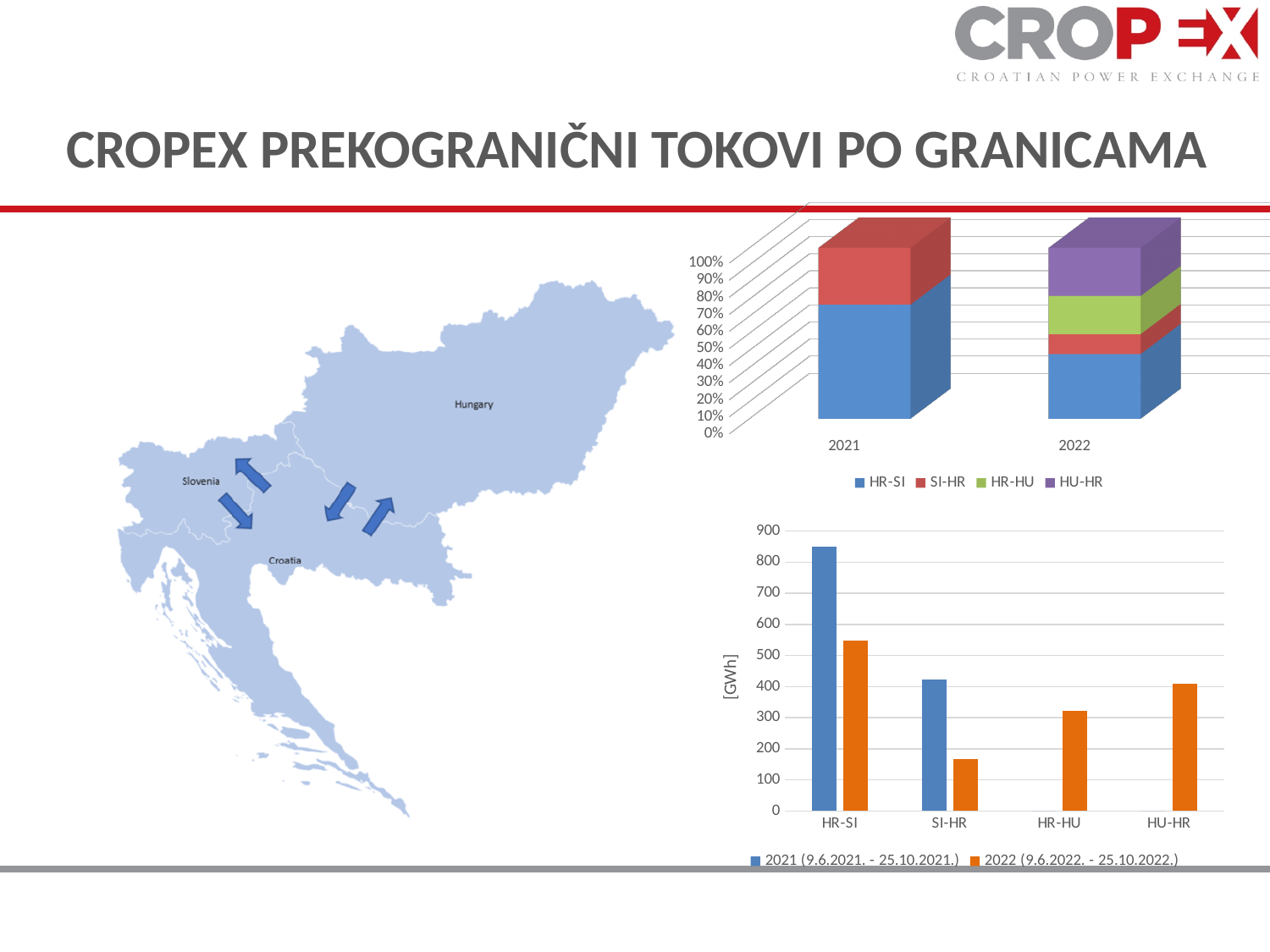
What kind of chart is the bottom chart with the [GWh] axis? bar chart In the bottom [GWh] chart, how many series does the legend list? 2 In the bottom [GWh] chart, which category has the highest 2021 value? HR-SI In the bottom [GWh] chart, is the 2022 value for SI-HR greater or less than 200? less In the bottom [GWh] chart, which is larger for 2022: HR-HU or HU-HR? HU-HR In the bottom [GWh] chart, is the 2022 value for HR-SI greater or less than 500? greater In the top stacked percentage chart, is the HR-SI share for 2021 greater or less than 50%? greater In the bottom [GWh] chart, how many categories are shown on the x axis? 4 In the bottom [GWh] chart, which category has the lowest 2022 value? SI-HR In the top stacked percentage chart, how many series does the legend list? 4 What unit is shown on the y axis of the bottom chart? [GWh]